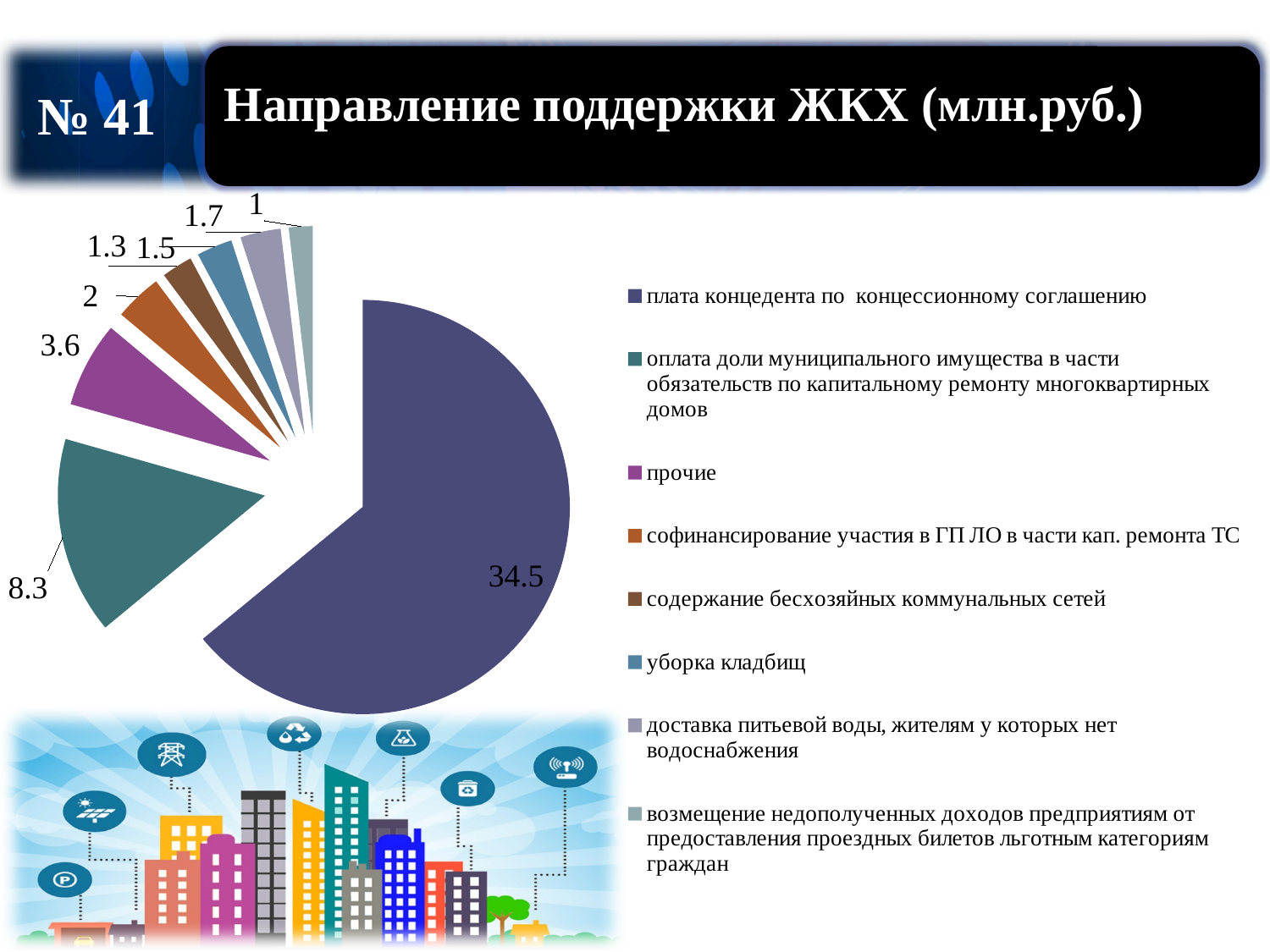
Which category has the largest slice of the pie? плата концедента по концессионному соглашению What is the value for «возмещение недополученных доходов предприятиям от предоставления проездных билетов льготным категориям граждан»? 1 What is the value for «уборка кладбищ»? 1.5 What is the value for «прочие»? 3.6 What is the difference between the values for «плата концедента по концессионному соглашению» and «оплата доли муниципального имущества в части обязательств по капитальному ремонту многоквартирных домов»? 26.2 What is the value for «оплата доли муниципального имущества в части обязательств по капитальному ремонту многоквартирных домов»? 8.3 What type of chart is shown on the slide? pie chart What is the value for «плата концедента по концессионному соглашению»? 34.5 Which is larger: the value for «содержание бесхозяйных коммунальных сетей» or the value for «доставка питьевой воды, жителям у которых нет водоснабжения»? доставка питьевой воды, жителям у которых нет водоснабжения What is the title of the chart? Направление поддержки ЖКХ (млн.руб.) Which category has the smallest slice of the pie? возмещение недополученных доходов предприятиям от предоставления проездных билетов льготным категориям граждан How many categories does the pie chart have? 8